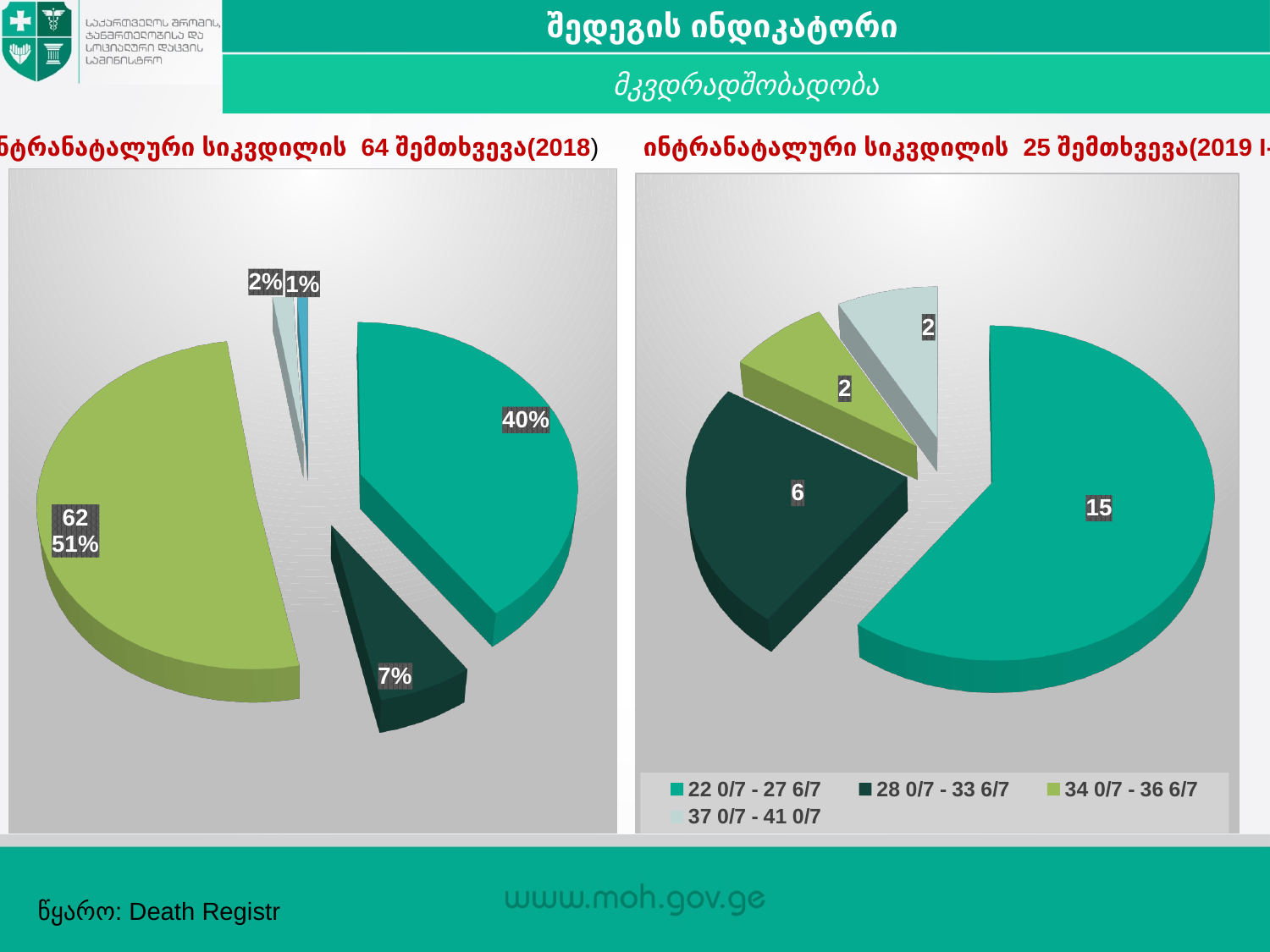
In the right pie chart, what is the value for the 34 0/7 - 36 6/7 category? 2 How many entries does the legend of the right pie chart list? 4 In the right pie chart, which is larger: the value for 28 0/7 - 33 6/7 or the value for 37 0/7 - 41 0/7? 28 0/7 - 33 6/7 In the right pie chart, what is the difference between the values for 22 0/7 - 27 6/7 and 28 0/7 - 33 6/7? 9 In the right pie chart, what is the value for the 22 0/7 - 27 6/7 category? 15 In the left pie chart, what percentage is shown on the largest slice? 51% How many slices does the left pie chart have? 5 In the right pie chart, what is the total of all the slice values? 25 In the right pie chart, what is the value for the 28 0/7 - 33 6/7 category? 6 What kind of chart is the left chart on the slide? pie chart In the right pie chart, which category has the largest slice? 22 0/7 - 27 6/7 In the right pie chart, what share of the total does the 22 0/7 - 27 6/7 slice represent? 60%